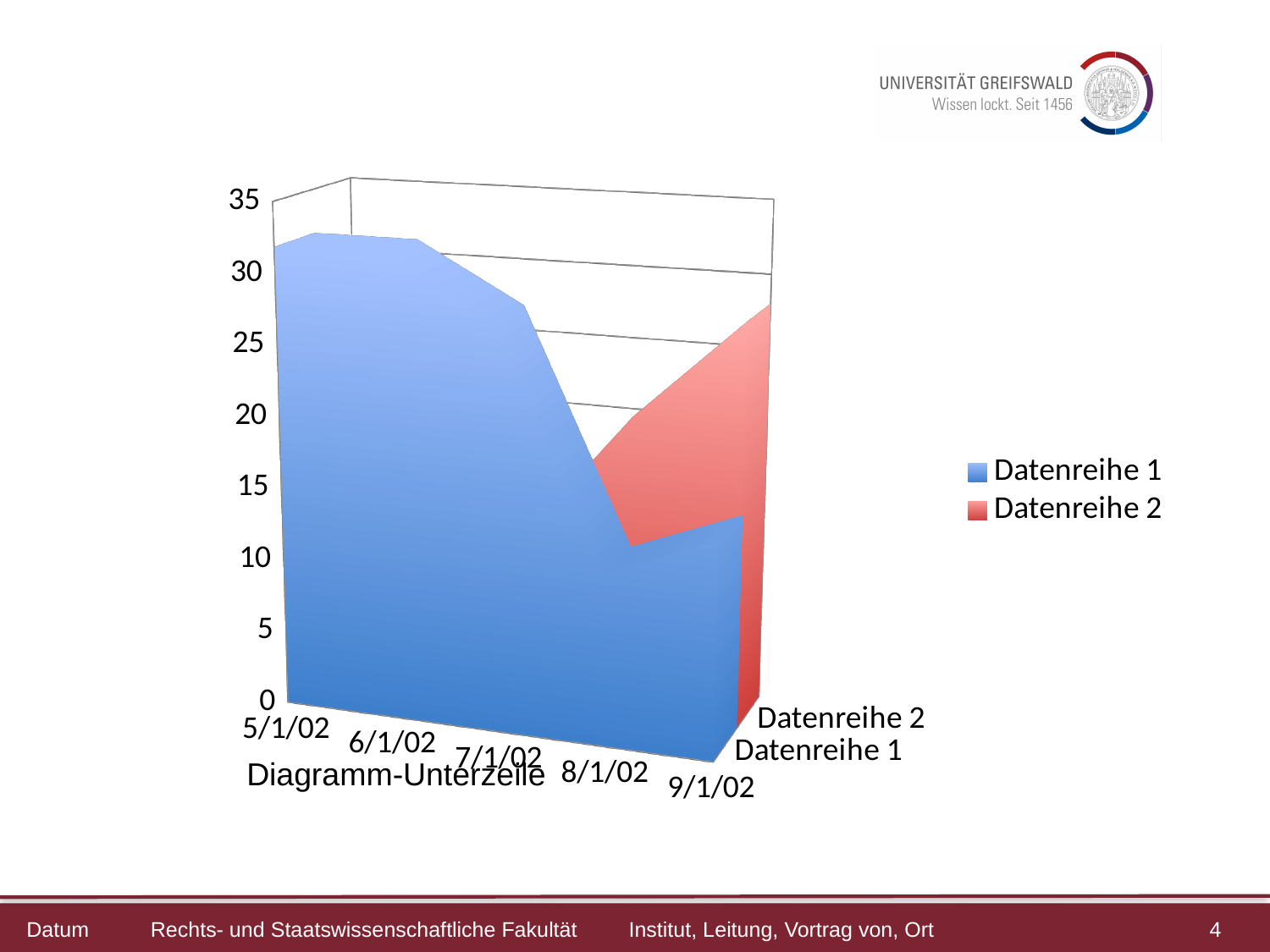
Is the value of Datenreihe 1 at 9/1/02 greater or less than 20? less How many dates are shown on the x axis? 5 What are the names of the two series in the legend? Datenreihe 1 and Datenreihe 2 What kind of chart is shown on the slide? area chart Does Datenreihe 1 rise or fall from 5/1/02 to 8/1/02? fall Is the value of Datenreihe 1 at 8/1/02 greater or less than 15? less At 9/1/02, which series has the larger value, Datenreihe 1 or Datenreihe 2? Datenreihe 2 Is the value of Datenreihe 2 at 9/1/02 greater or less than 20? greater How many series does the legend list? 2 Which colour represents Datenreihe 2? red Which is larger for Datenreihe 1: the value at 5/1/02 or the value at 8/1/02? 5/1/02